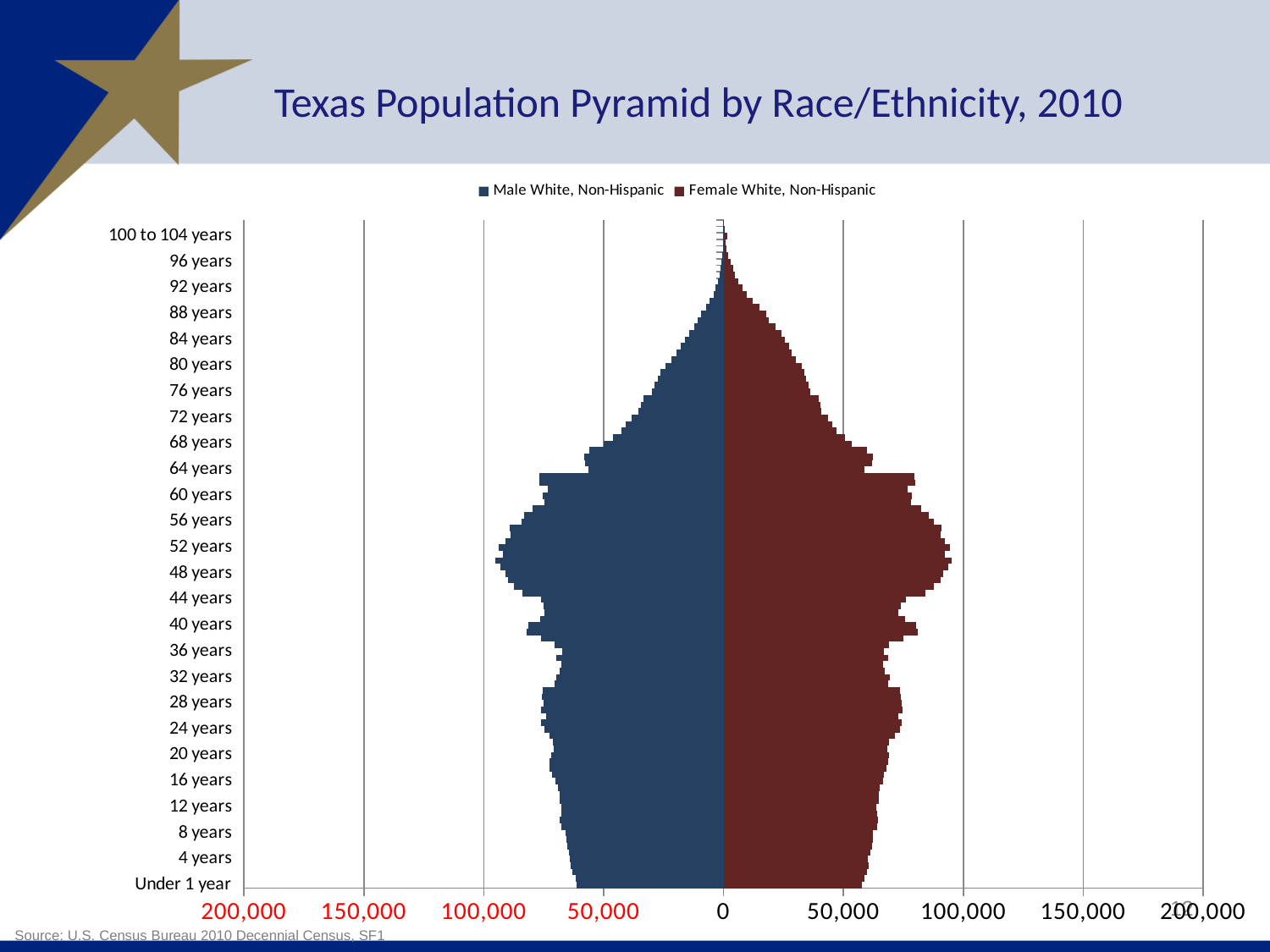
Is the value for Male White, Non-Hispanic at 52 years greater or less than 50,000? greater What kind of chart is shown on the slide? Bar chart Which series is shown in dark red? Female White, Non-Hispanic Is the value for Male White, Non-Hispanic at 100 to 104 years greater or less than 50,000? less Is the value for Male White, Non-Hispanic at 52 years greater or less than 100,000? less How many series does the legend list? 2 Which is larger for Female White, Non-Hispanic: the value at 60 years or the value at 88 years? 60 years Which is larger for Male White, Non-Hispanic: the value at 52 years or the value at 80 years? 52 years What is the title of the chart? Texas Population Pyramid by Race/Ethnicity, 2010 Going from 100 to 104 years down to 52 years, do the Male White, Non-Hispanic bars get longer or shorter? longer